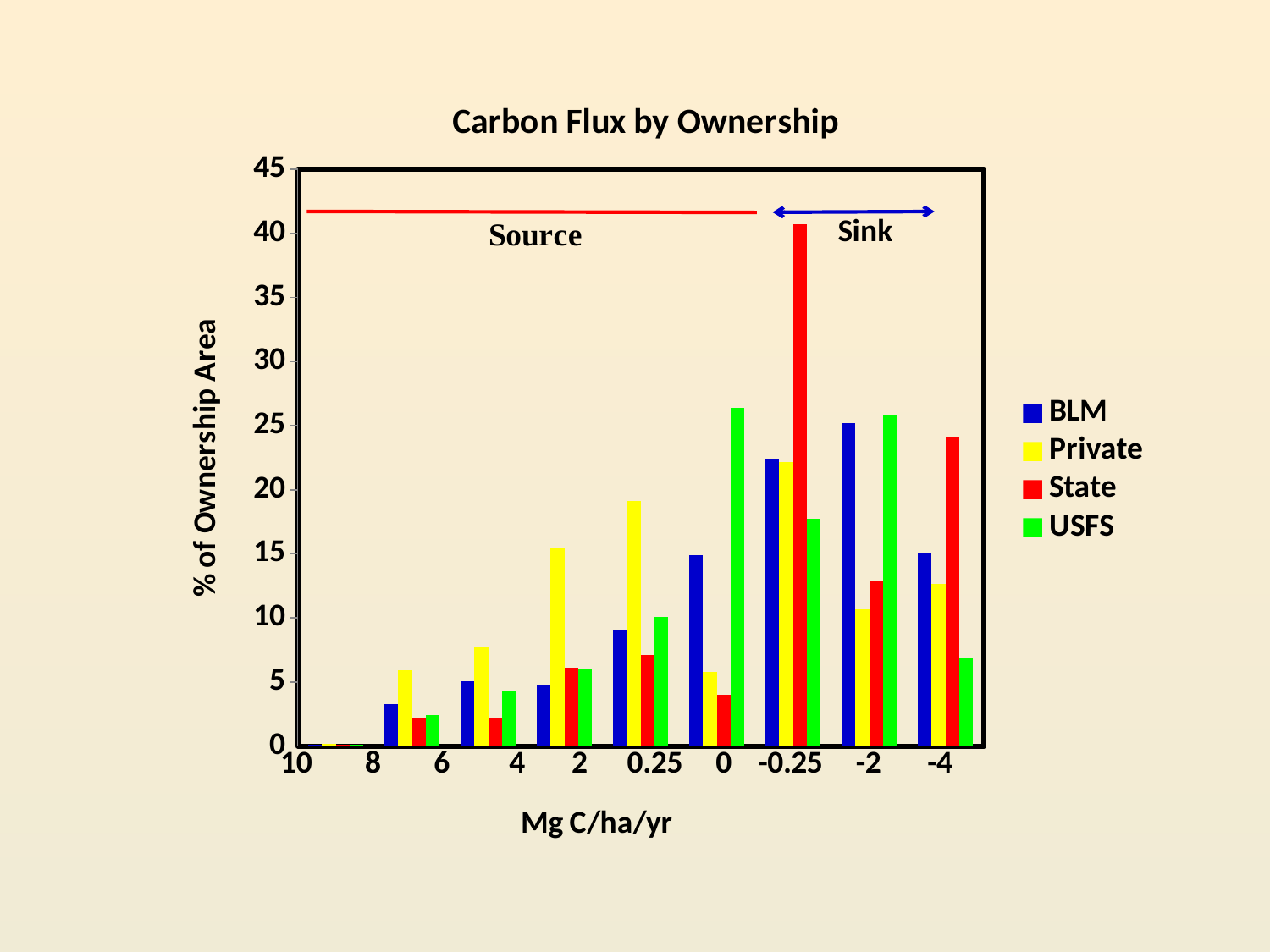
At 2 Mg C/ha/yr, which is larger, the Private bar or the BLM bar? Private Is the value for State at -0.25 Mg C/ha/yr greater or less than 35? greater Is the value for BLM at -2 Mg C/ha/yr greater or less than 20? greater Which series has the tallest bar at the -0.25 Mg C/ha/yr category? State Is the value for USFS at 0 Mg C/ha/yr greater or less than 25? greater How many series does the legend list? 4 At -4 Mg C/ha/yr, which is larger, the State bar or the USFS bar? State Which series has the tallest bar at the 0.25 Mg C/ha/yr category? Private What kind of chart is shown on the slide? bar chart What is the title of the chart? Carbon Flux by Ownership